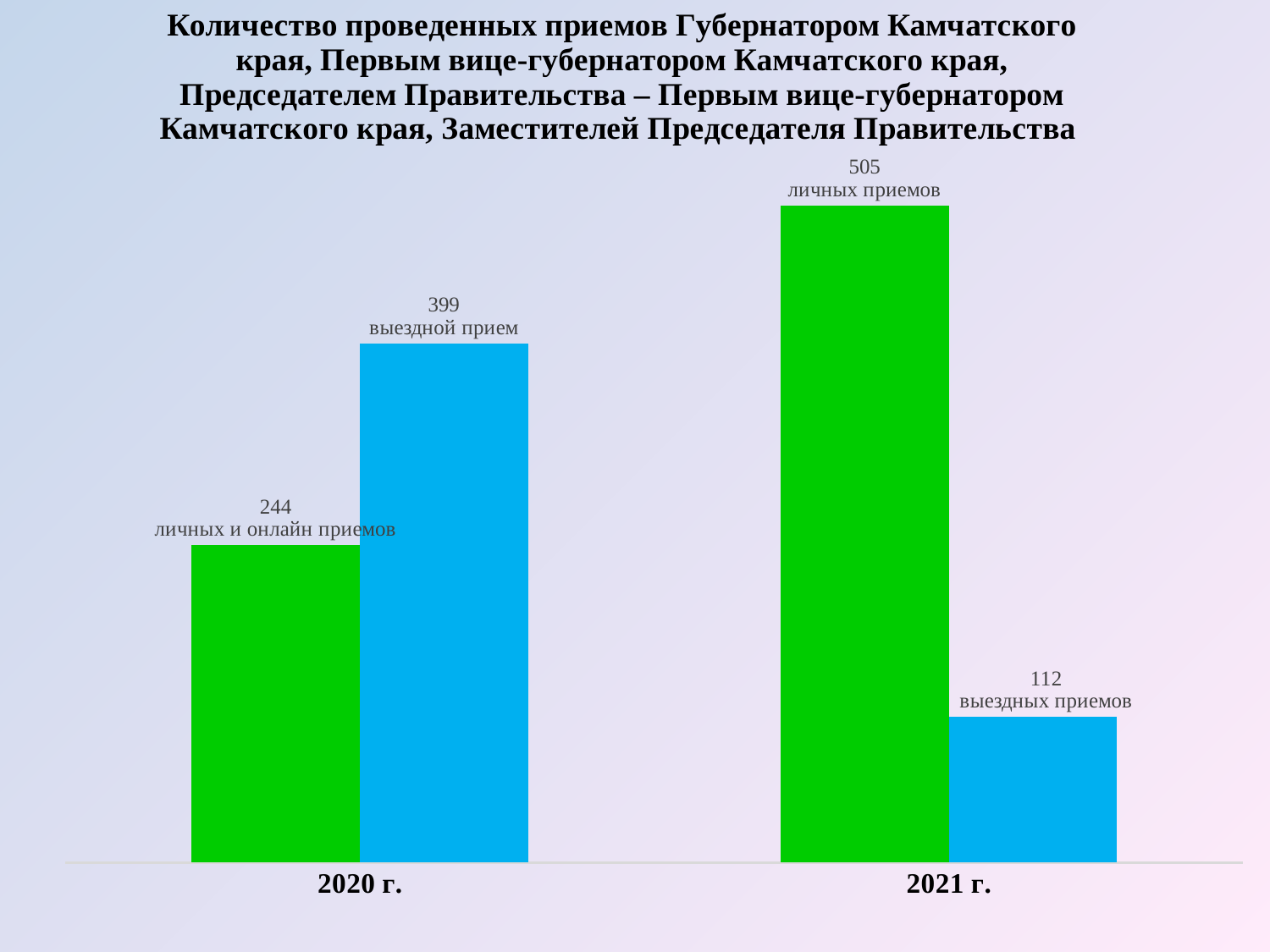
Which bar has the lowest value on the chart? 112 выездных приемов (2021 г.) What kind of chart is shown on the slide? Bar chart How many personal receptions (личных приемов) were held in 2021 г.? 505 How many on-site receptions (выездной прием) were held in 2020 г.? 399 Which is larger: on-site receptions in 2020 г. or on-site receptions in 2021 г.? 2020 г. (399) What colour are the bars representing on-site receptions (выездной прием / выездных приемов)? Blue How many year categories are shown on the x axis? 2 What is the difference between the number of personal receptions in 2021 г. (505) and personal and online receptions in 2020 г. (244)? 261 How many personal and online receptions (личных и онлайн приемов) were held in 2020 г.? 244 Which bar has the highest value on the chart? 505 личных приемов (2021 г.) How many on-site receptions (выездных приемов) were held in 2021 г.? 112 What is the difference between on-site receptions in 2020 г. (399) and on-site receptions in 2021 г. (112)? 287